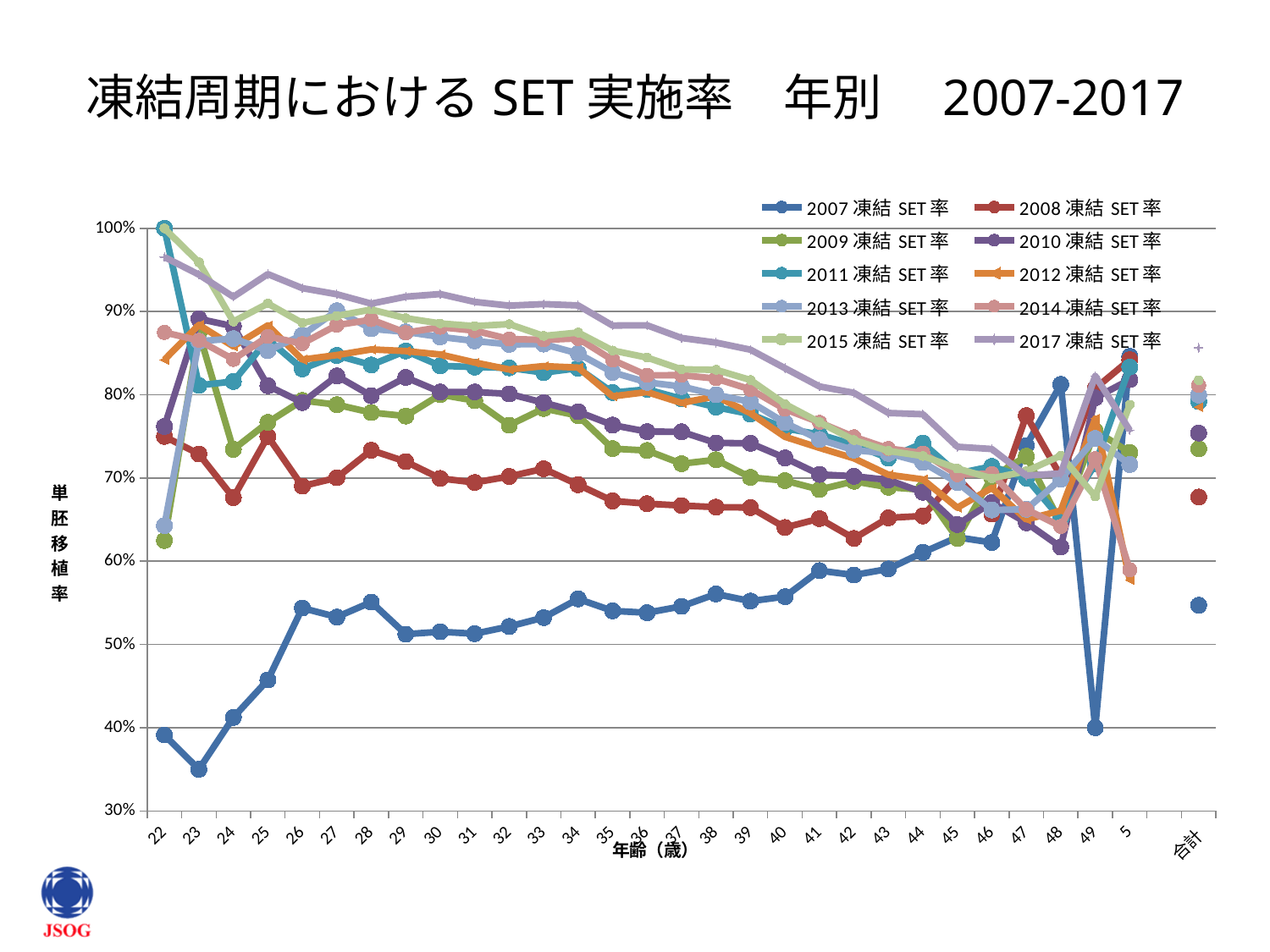
Which series has the highest value at age 30? 2017 凍結 SET 率 Is the value for the 2008 凍結 SET 率 series at age 22 greater or less than 70%? greater Is the value for the 2008 凍結 SET 率 series at age 42 greater or less than 70%? less What kind of chart is shown on the slide? line chart Is the value for the 2017 凍結 SET 率 series at age 25 greater or less than 90%? greater Which series has the lowest value at age 30? 2007 凍結 SET 率 At age 35, which is larger: the 2017 凍結 SET 率 value or the 2008 凍結 SET 率 value? 2017 凍結 SET 率 Does the 2017 凍結 SET 率 series generally rise or fall from age 22 to age 45? fall How many series does the legend list? 10 What is the label of the x axis? 年齢（歳） What is the title of the chart? 凍結周期における SET 実施率 年別 2007-2017